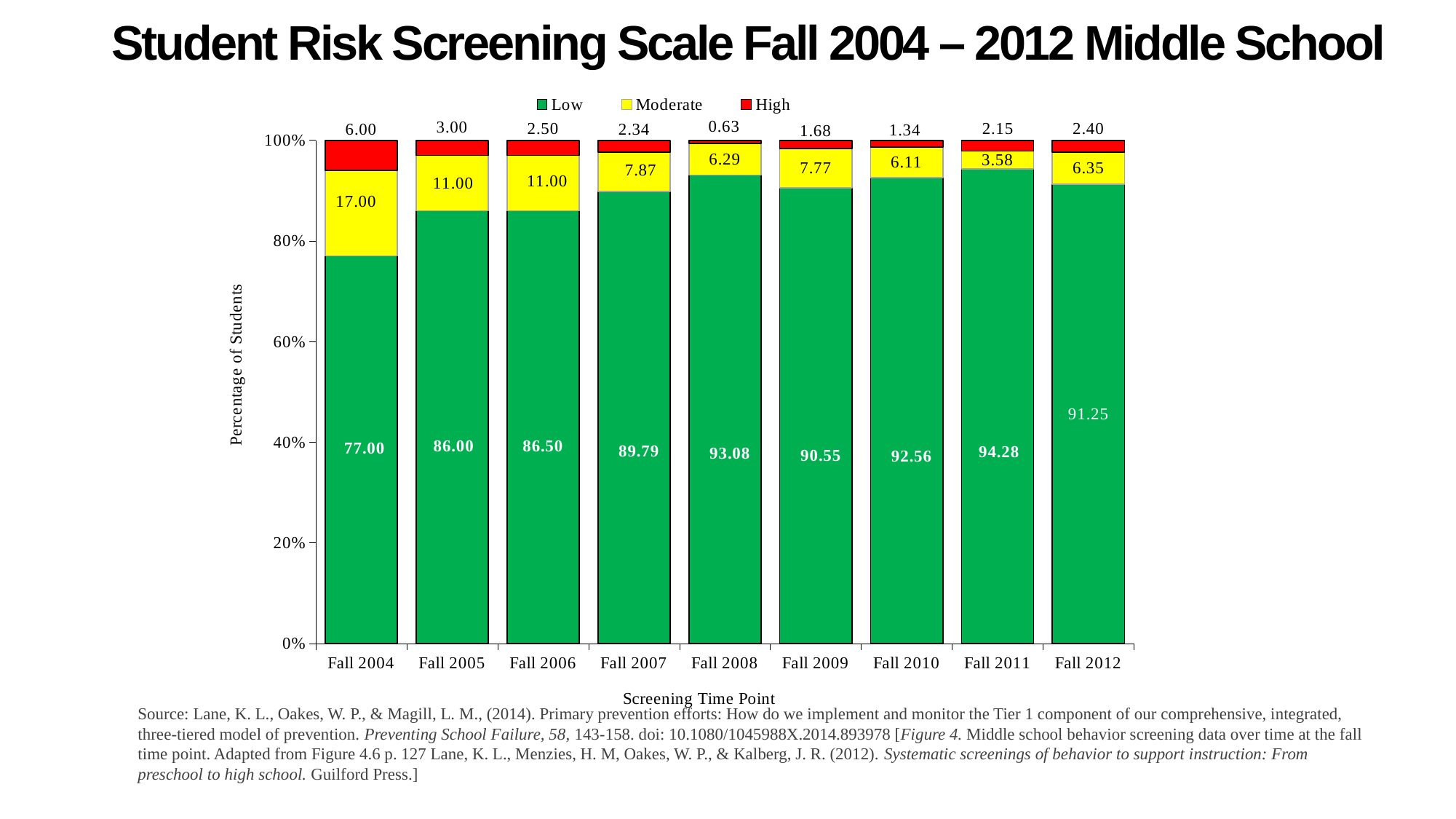
Does the Moderate value generally rise or fall from Fall 2004 to Fall 2011? Fall What kind of chart is shown on the slide? Stacked bar chart Which screening time point has the highest Low value? Fall 2011 What is the Moderate value for Fall 2009? 7.77 What is the Low value for Fall 2004? 77.00 Which screening time point has the lowest High value? Fall 2008 What is the High value for Fall 2008? 0.63 How many series does the legend list? 3 What is the label on the y axis? Percentage of Students What is the difference between the Low values for Fall 2011 and Fall 2004? 17.28 How many screening time points are shown on the x axis? 9 Is the Moderate value larger for Fall 2005 or Fall 2012? Fall 2005